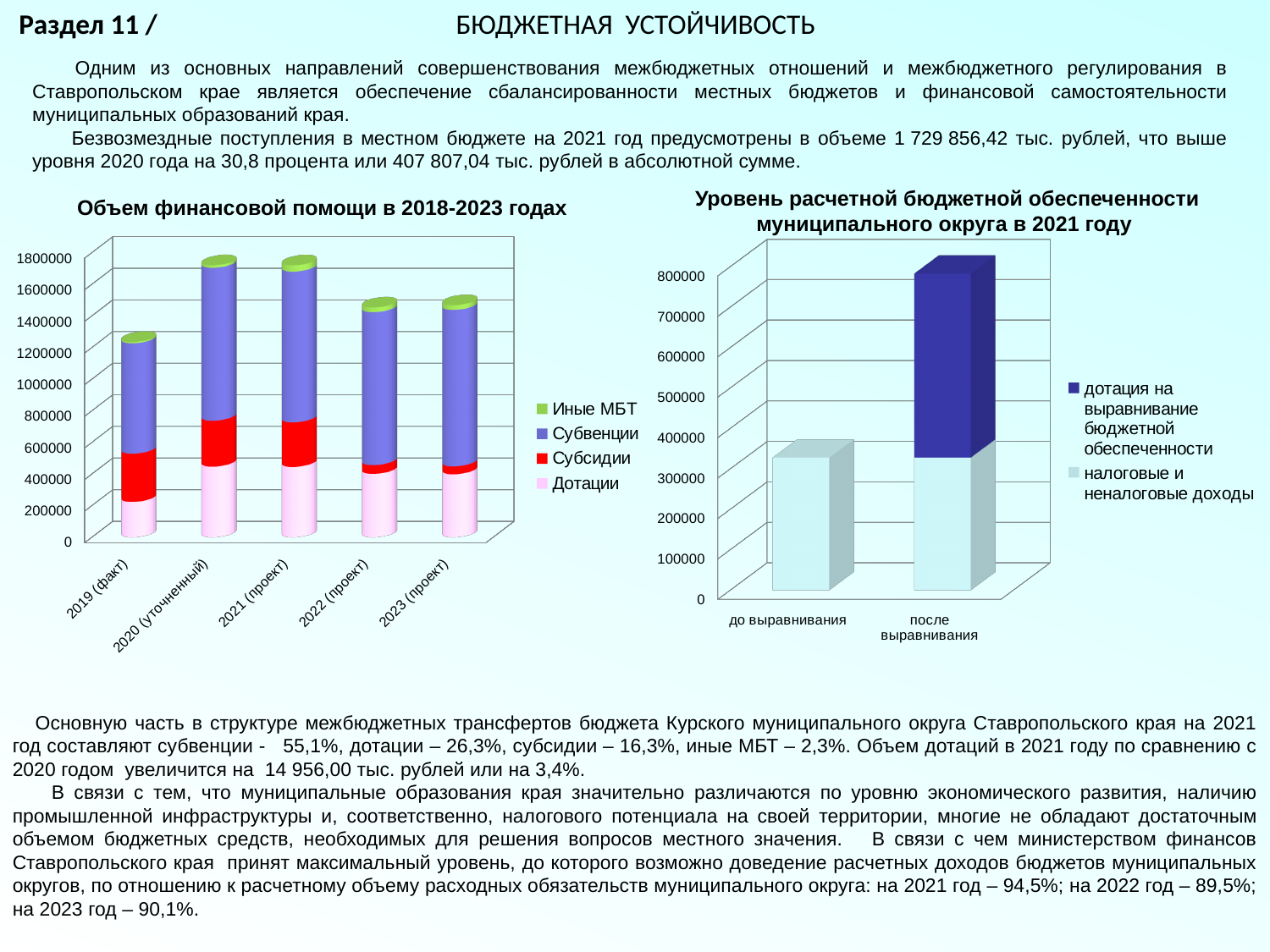
In the chart "Объем финансовой помощи в 2018-2023 годах", is the total bar for 2019 (факт) greater or less than 1400000? less In the chart "Объем финансовой помощи в 2018-2023 годах", which total bar is taller: 2019 (факт) or 2022 (проект)? 2022 (проект) In the chart "Объем финансовой помощи в 2018-2023 годах", which legend entry is shown in red? Субсидии How many categories are shown on the x axis of the chart "Уровень расчетной бюджетной обеспеченности муниципального округа в 2021 году"? 2 How many series does the legend of the chart "Уровень расчетной бюджетной обеспеченности муниципального округа в 2021 году" list? 2 In the chart "Объем финансовой помощи в 2018-2023 годах", is the total bar for 2020 (уточненный) greater or less than 1600000? greater In the chart "Уровень расчетной бюджетной обеспеченности муниципального округа в 2021 году", which category has the highest total bar? после выравнивания What kind of chart is "Объем финансовой помощи в 2018-2023 годах"? Stacked bar chart In the chart "Объем финансовой помощи в 2018-2023 годах", which category has the lowest total bar? 2019 (факт) How many series does the legend of the chart "Объем финансовой помощи в 2018-2023 годах" list? 4 In the chart "Уровень расчетной бюджетной обеспеченности муниципального округа в 2021 году", is the value for "до выравнивания" greater or less than 400000? less How many categories are shown on the x axis of the chart "Объем финансовой помощи в 2018-2023 годах"? 5